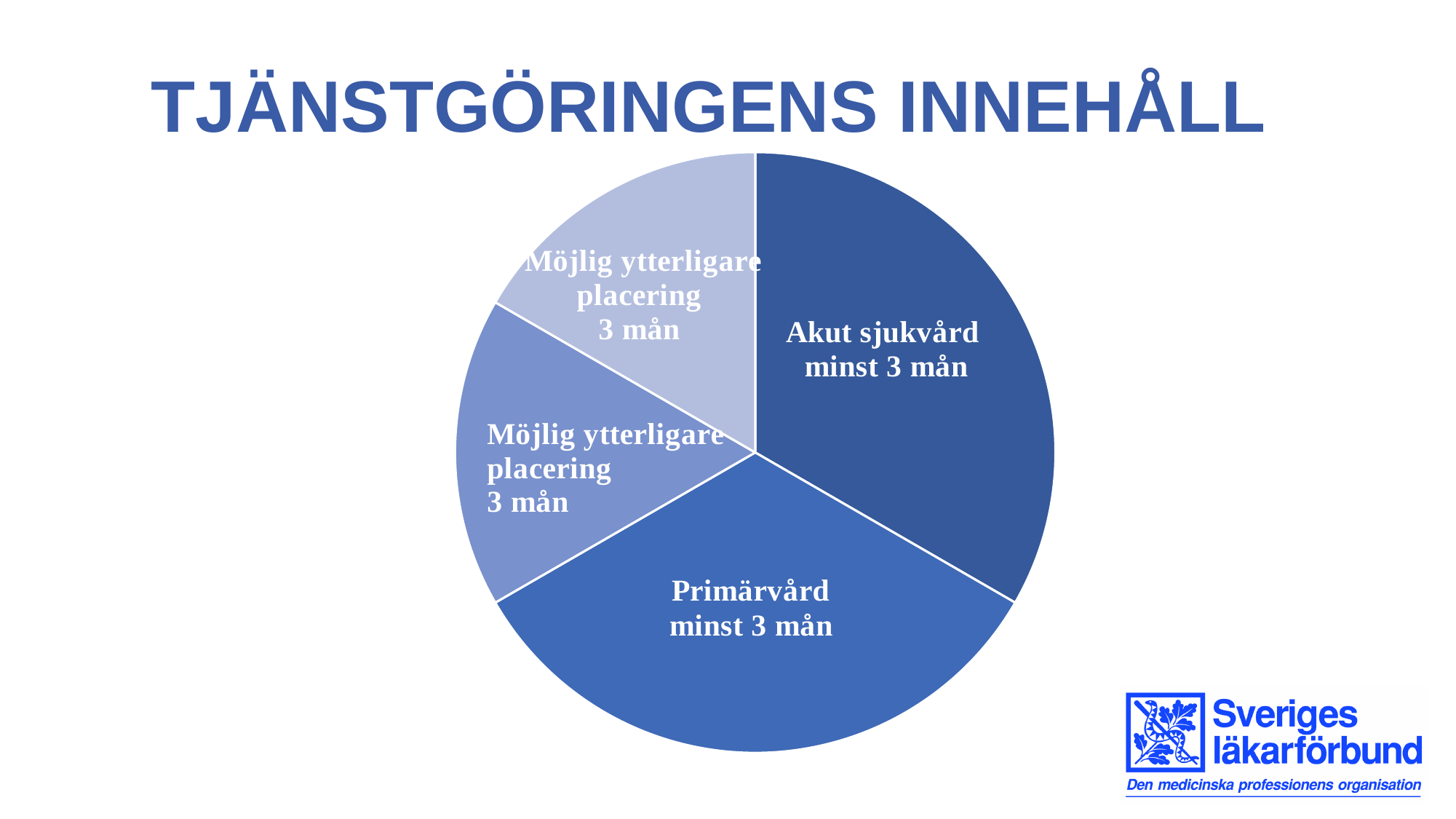
How many slices in the pie chart are labelled Möjlig ytterligare placering? 2 Which slice is larger: Primärvård or the left Möjlig ytterligare placering slice? Primärvård What is the label of the darkest blue slice on the right side of the pie chart? Akut sjukvård minst 3 mån What duration is stated for each Möjlig ytterligare placering slice? 3 mån Which slice is larger: Akut sjukvård or the upper-left Möjlig ytterligare placering slice? Akut sjukvård What minimum duration is stated for Primärvård in the pie chart? minst 3 mån Does the Akut sjukvård slice take up more or less than half of the pie? less How many slices does the pie chart have? 4 What type of chart is shown on the slide? Pie chart What is the title of the slide above the pie chart? TJÄNSTGÖRINGENS INNEHÅLL